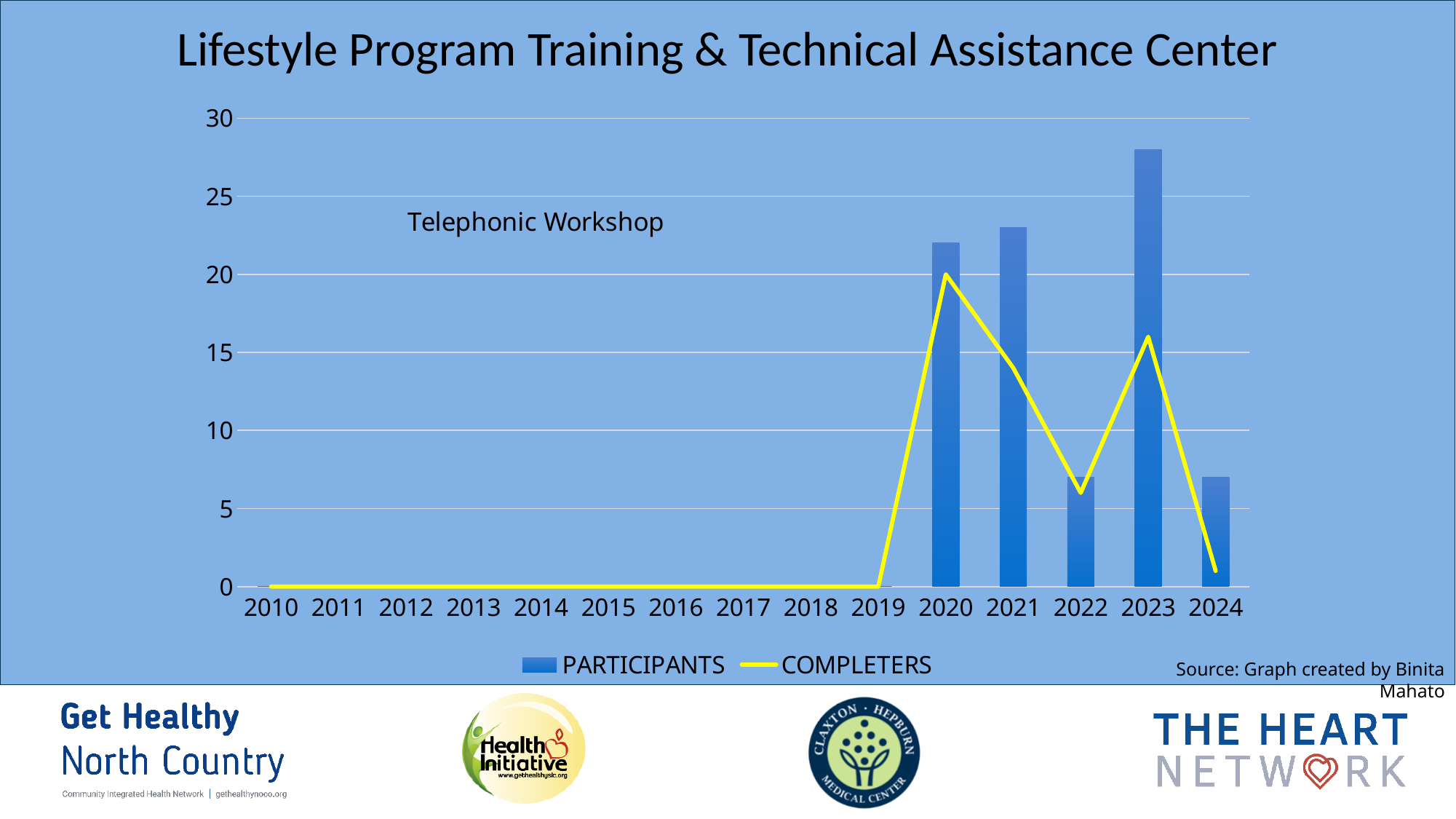
Is the COMPLETERS value for 2023 greater or less than 15? greater Is the PARTICIPANTS value for 2020 greater or less than 20? greater How many series does the legend list? 2 How many years are shown on the x axis? 15 Is the PARTICIPANTS value for 2023 greater or less than 25? greater Do the COMPLETERS values rise or fall from 2020 to 2022? fall Which year has the highest number of COMPLETERS? 2020 Which year has more PARTICIPANTS, 2021 or 2022? 2021 Which year has the highest number of PARTICIPANTS? 2023 What are the two entries in the chart legend? PARTICIPANTS and COMPLETERS What kind of chart is shown on the slide? A combined bar and line chart